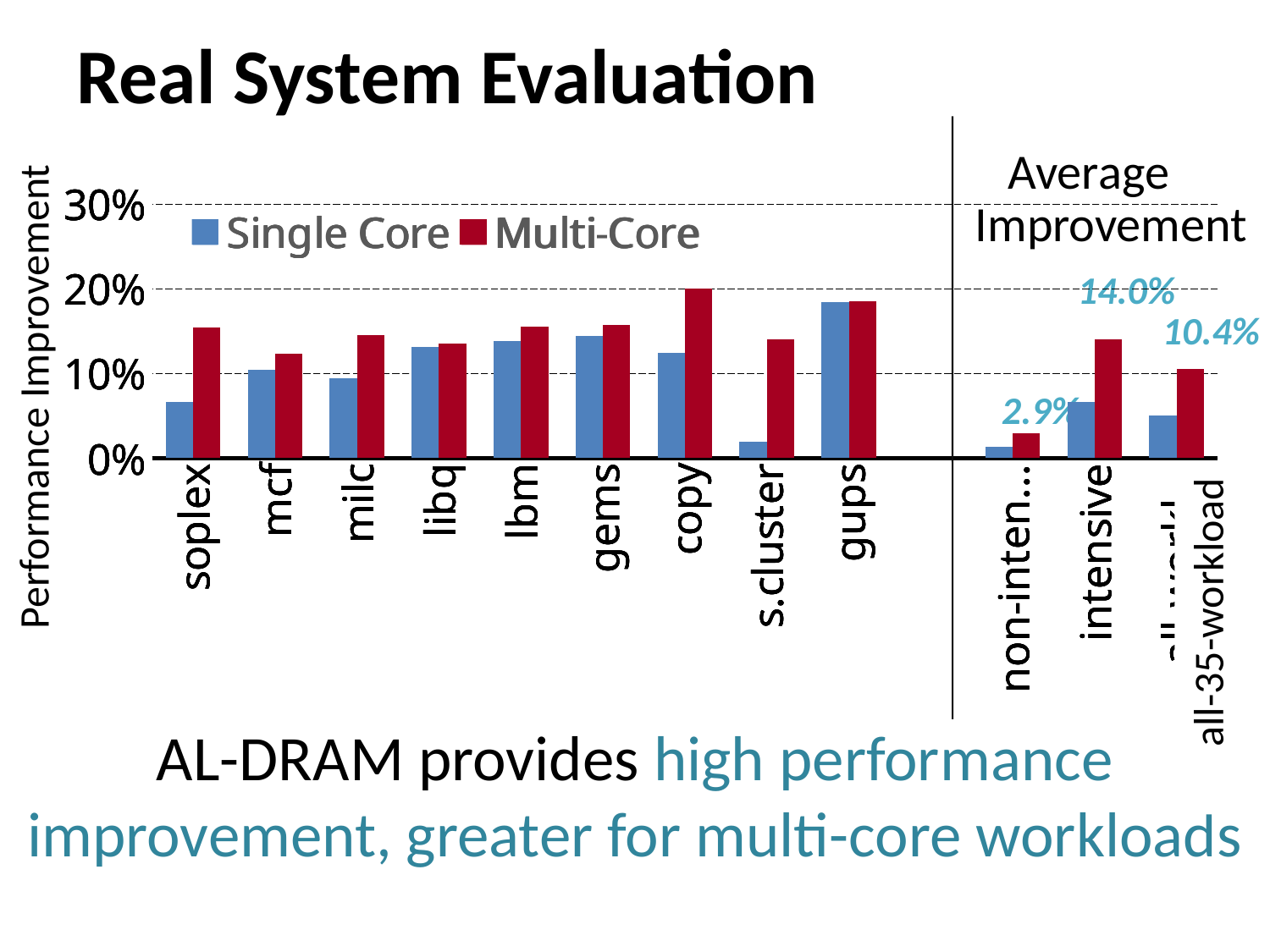
What is the difference between the labelled Multi-Core average improvement for intensive workloads (14.0%) and for all-35-workload (10.4%)? 3.6% Among the individual benchmarks left of the divider, which has the highest Multi-Core performance improvement? copy What kind of chart is shown on the slide? bar chart Among the individual benchmarks left of the divider, which has the lowest Single Core performance improvement? s.cluster What are the two series named in the chart legend? Single Core and Multi-Core How many series does the chart legend list? 2 What is the Multi-Core average improvement labelled for all-35-workload? 10.4% Is the Multi-Core performance improvement for copy greater or less than 10%? greater For soplex, which is larger: the Single Core or the Multi-Core performance improvement? Multi-Core What is the title of the slide containing the chart? Real System Evaluation How many individual benchmarks are plotted to the left of the vertical divider line? 9 What is the Multi-Core average improvement labelled for the intensive workloads? 14.0%